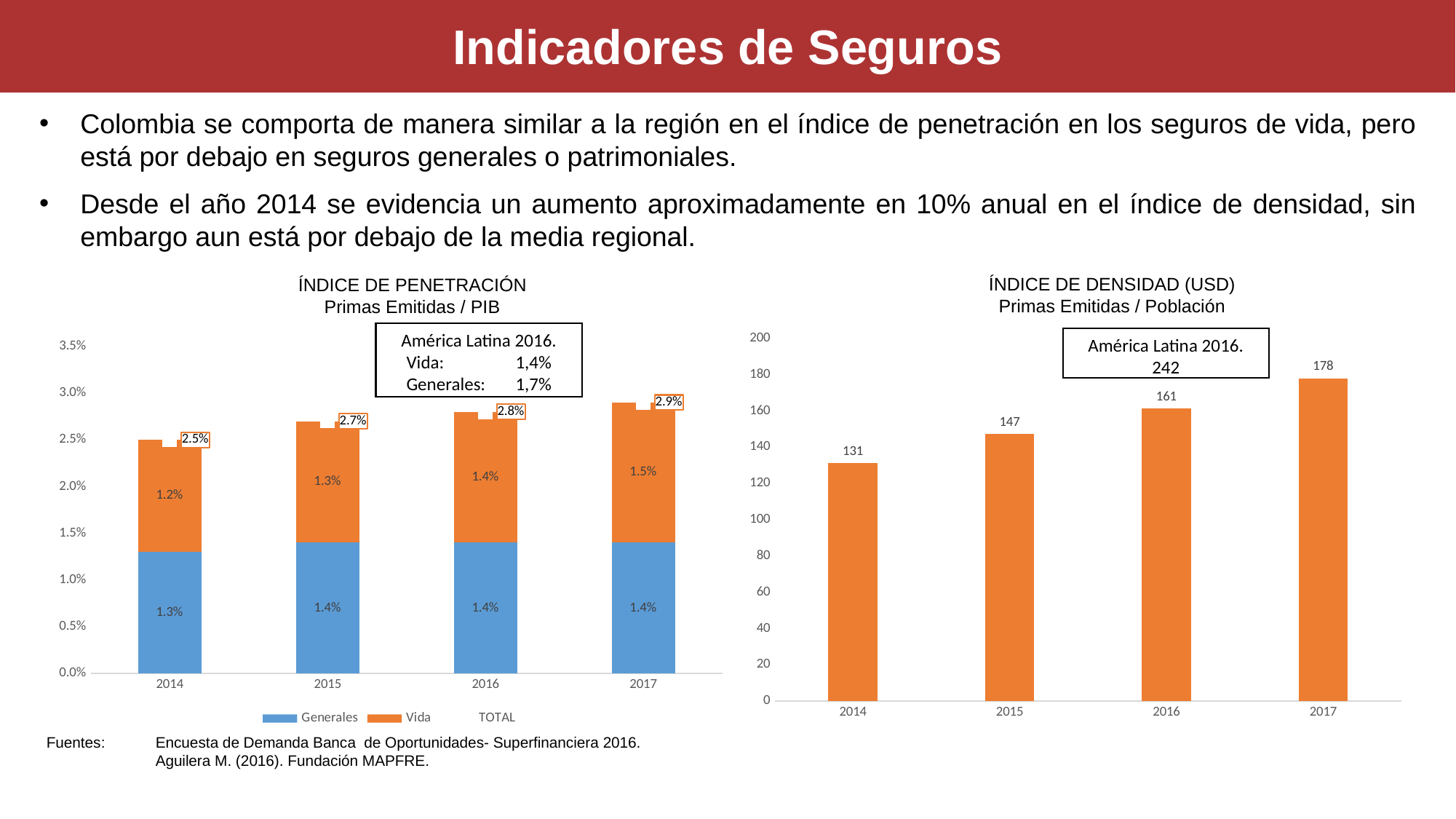
In the ÍNDICE DE PENETRACIÓN chart, what is the Vida value for 2017? 1.5% In the ÍNDICE DE DENSIDAD (USD) chart, do the values rise or fall from 2014 to 2017? rise In the ÍNDICE DE DENSIDAD (USD) chart, which year has the highest value? 2017 In the ÍNDICE DE DENSIDAD (USD) chart, what is the value for 2014? 131 In the ÍNDICE DE DENSIDAD (USD) chart, what is the value for 2017? 178 In the ÍNDICE DE DENSIDAD (USD) chart, how many years are plotted? 4 In the ÍNDICE DE PENETRACIÓN chart, what is the total of the stacked bar for 2016? 2.8% In the ÍNDICE DE PENETRACIÓN chart, what is the Generales value for 2014? 1.3% What kind of chart is the ÍNDICE DE DENSIDAD (USD) chart? bar chart In the ÍNDICE DE DENSIDAD (USD) chart, what is the difference between the 2016 and 2015 values? 14 In the ÍNDICE DE PENETRACIÓN chart, how many entries does the legend list? 3 In the ÍNDICE DE PENETRACIÓN chart, which is larger for 2014: Generales or Vida? Generales